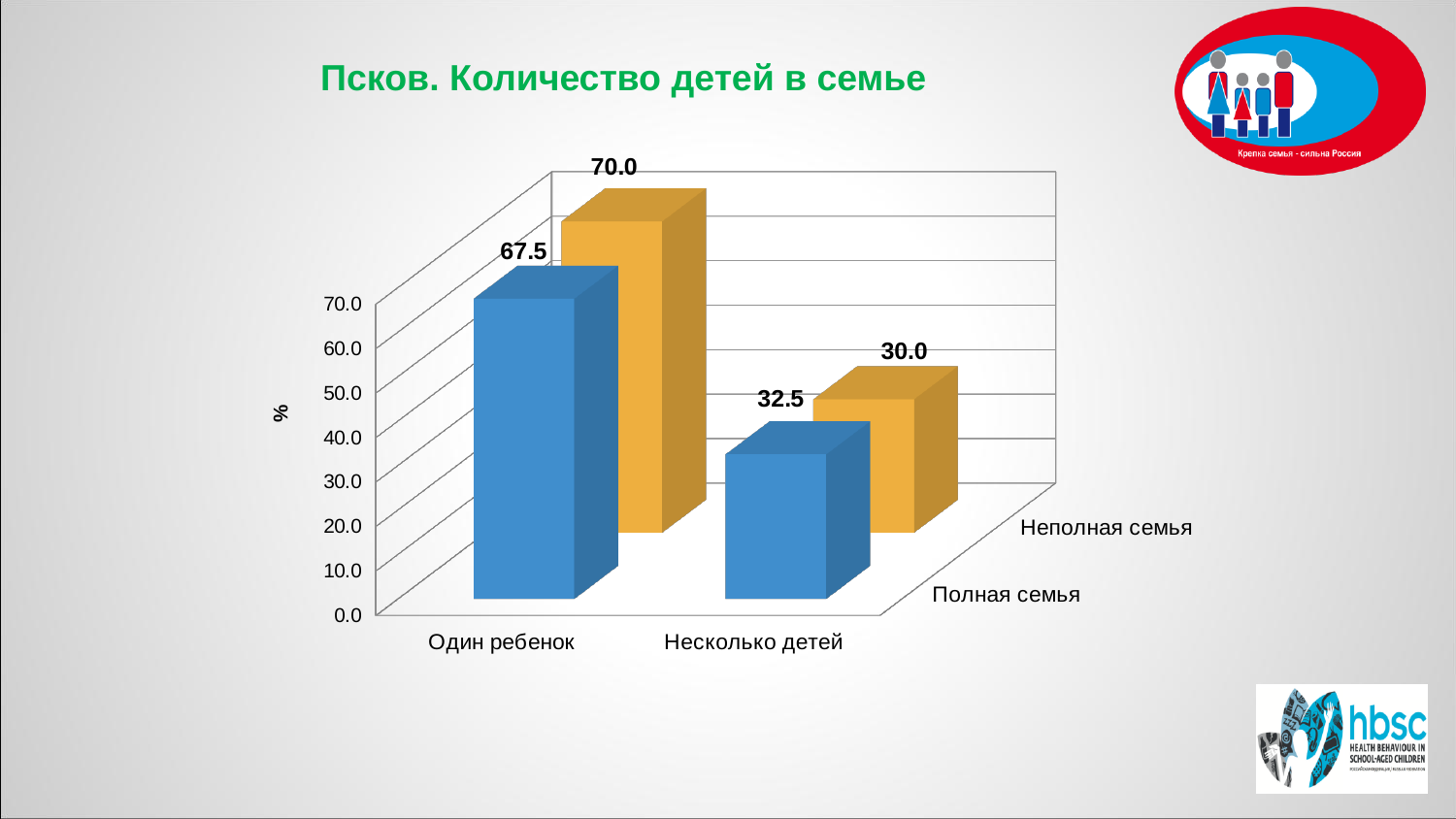
For Один ребенок, which series has the larger value: Полная семья or Неполная семья? Неполная семья What is the value for Один ребенок in the Полная семья series? 67.5 What kind of chart is shown on the slide? Bar chart Which category has the highest value in the Неполная семья series? Один ребенок What is the title of the chart? Псков. Количество детей в семье What is the difference between the Полная семья values for Один ребенок and Несколько детей? 35.0 What is the difference between the Неполная семья and Полная семья values for Несколько детей? -2.5 Which category has the lowest value in the Полная семья series? Несколько детей What is the value for Несколько детей in the Неполная семья series? 30.0 What is the value for Несколько детей in the Полная семья series? 32.5 How many categories are shown on the x axis? 2 What is the value for Один ребенок in the Неполная семья series? 70.0